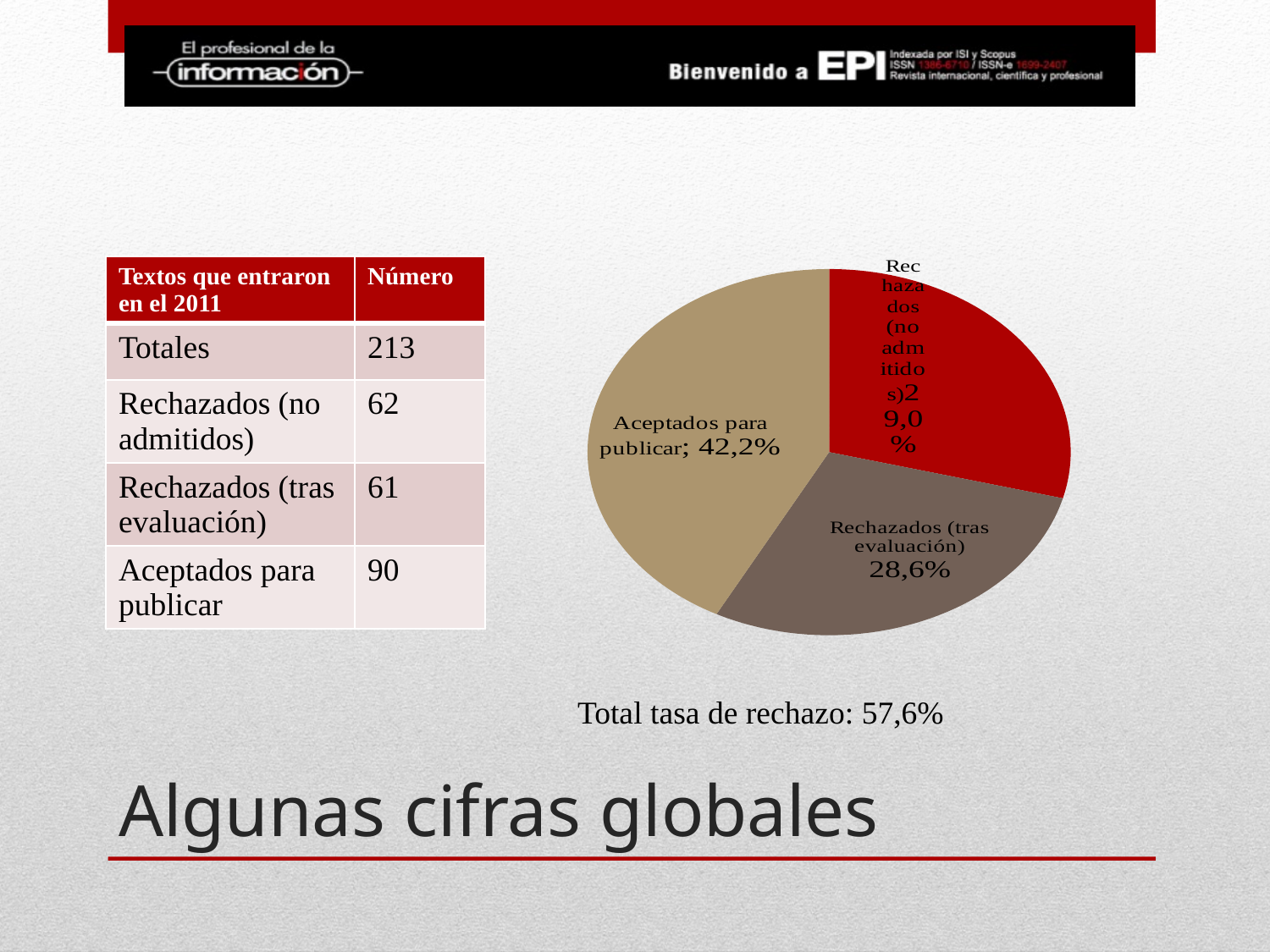
What percentage of the pie chart is 'Rechazados (tras evaluación)'? 28,6% What percentage of the pie chart is 'Rechazados (no admitidos)'? 29,0% Which slice of the pie chart is the smallest? Rechazados (tras evaluación) What colour is the 'Rechazados (no admitidos)' slice in the pie chart? Red What percentage of the pie chart is 'Aceptados para publicar'? 42,2% Which slice of the pie chart is the largest? Aceptados para publicar In the pie chart, which is larger: 'Aceptados para publicar' or 'Rechazados (no admitidos)'? Aceptados para publicar What is the difference in percentage points between 'Aceptados para publicar' and 'Rechazados (tras evaluación)' in the pie chart? 13,6 What kind of chart is shown on the slide? Pie chart How many slices does the pie chart have? 3 What colour is the 'Aceptados para publicar' slice in the pie chart? Tan (beige) What is the difference in percentage points between 'Rechazados (no admitidos)' and 'Rechazados (tras evaluación)' in the pie chart? 0,4